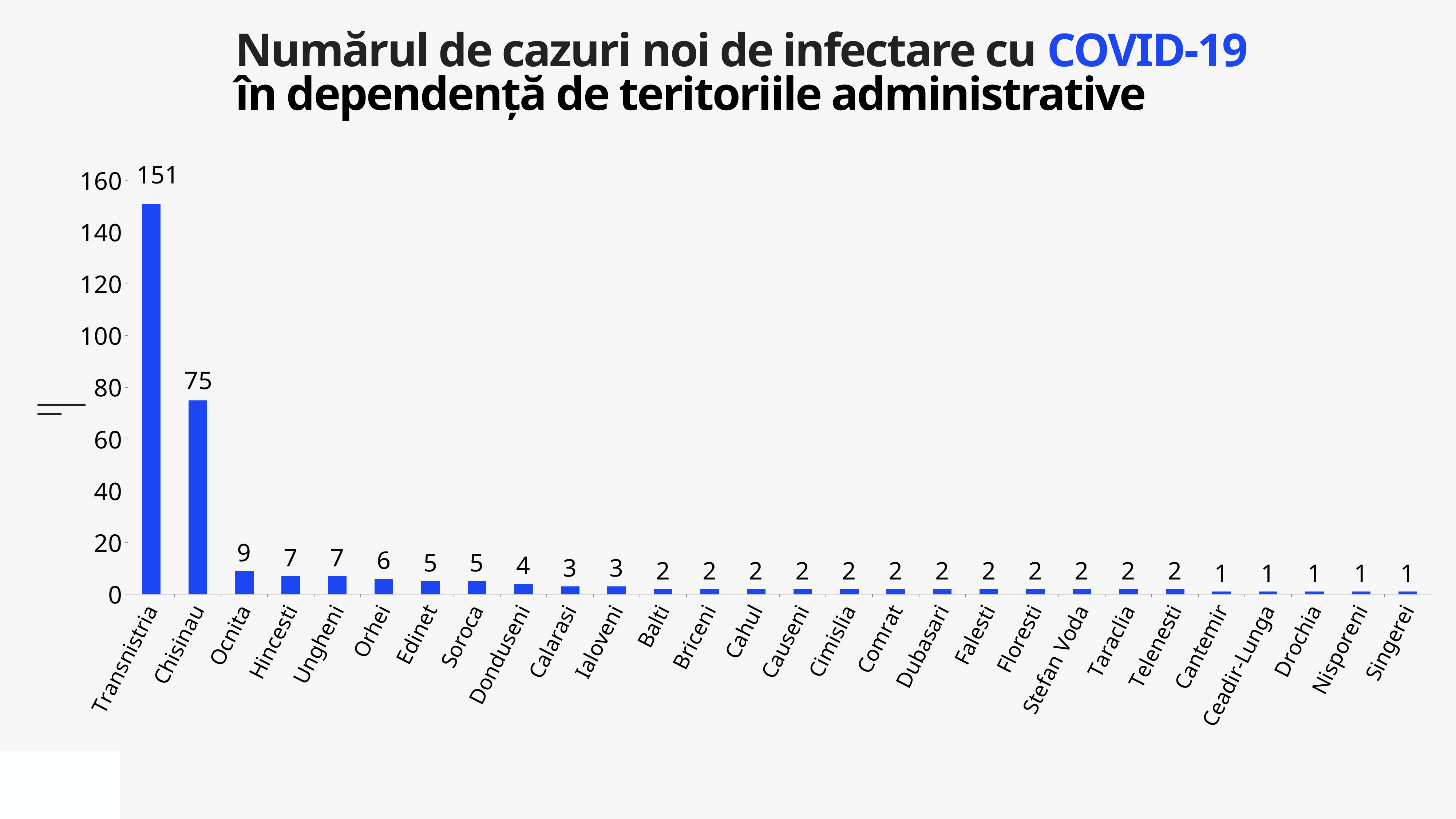
What is the value for Chisinau? 75 What kind of chart is shown on the slide? bar chart What is the difference between the values for Transnistria and Chisinau? 76 How many territories are shown on the x axis? 28 Which territory has the highest number of new cases? Transnistria How many territories have a value of 1? 5 What is the value for Ocnita? 9 Which has a larger value, Hincesti or Donduseni? Hincesti What is the value for Transnistria? 151 Do the values rise or fall from left to right along the x axis? fall What is the value for Orhei? 6 Is the value for Chisinau greater or less than 80? less